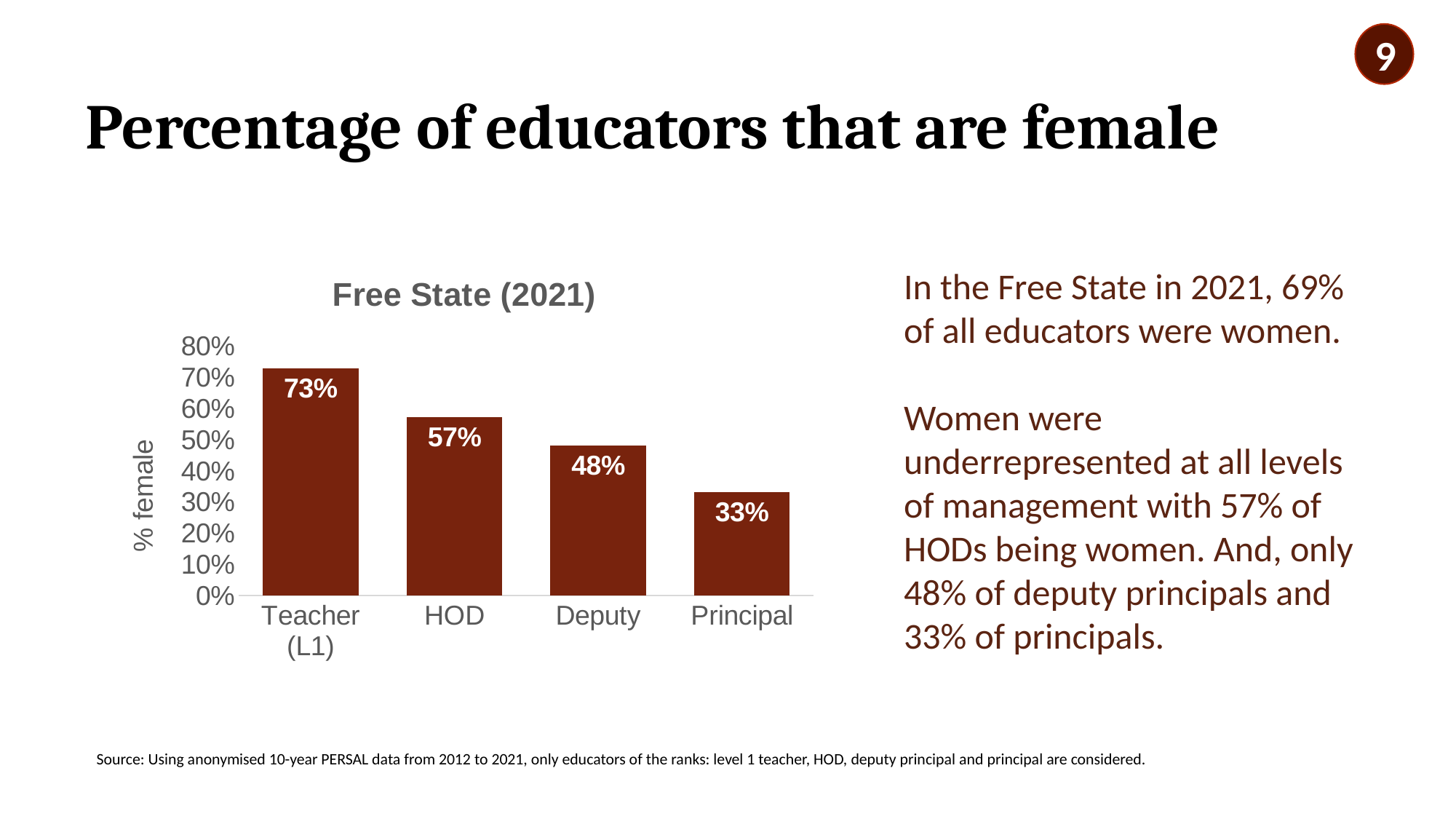
Which is larger, the value for HOD or the value for Deputy? HOD What percentage of Teacher (L1) educators are female in the Free State (2021) chart? 73% What is the difference between the HOD value and the Deputy value? 9% Do the values rise or fall from Teacher (L1) to Principal along the x axis? Fall What is the value shown for Deputy in the chart? 48% What is the value shown for HOD in the chart? 57% Which category has the lowest percentage of female educators? Principal What is the difference between the Teacher (L1) value and the Principal value? 40% What kind of chart is shown on the slide? Bar chart Which category has the highest percentage of female educators? Teacher (L1) What is the value shown for Principal in the chart? 33% How many categories are shown on the x axis of the chart? 4